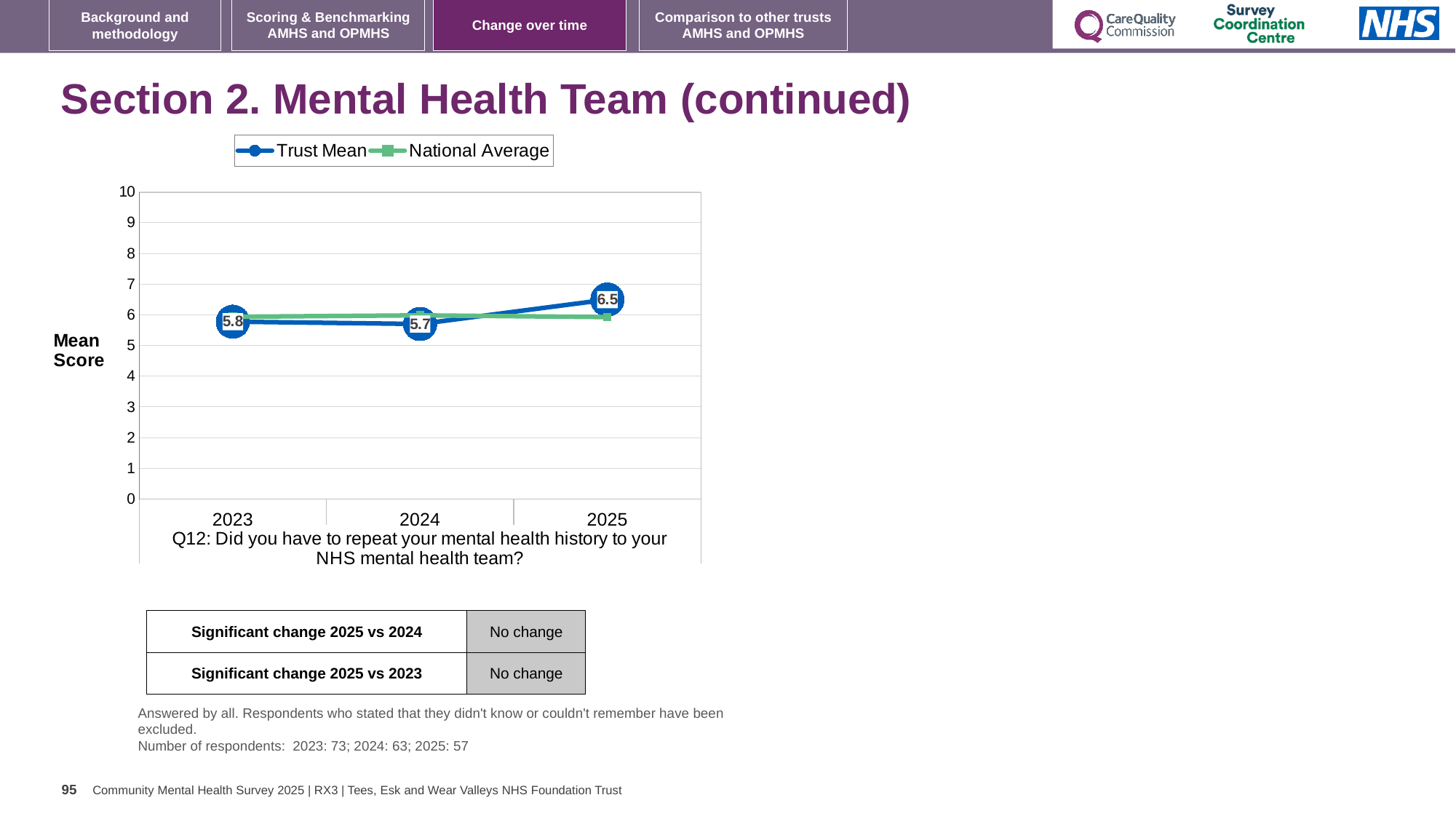
In which year is the Trust Mean score highest? 2025 Does the Trust Mean rise or fall from 2024 to 2025? rise In 2025, which is larger: the Trust Mean or the National Average? Trust Mean What is the difference between the Trust Mean scores for 2025 and 2024? 0.8 What is the Trust Mean score for 2023? 5.8 Is the National Average value for 2025 greater or less than 7? less How many series does the legend list? 2 What is the Trust Mean score for 2025? 6.5 In which year is the Trust Mean score lowest? 2024 What kind of chart is shown on the slide? line chart How many years are plotted on the x axis? 3 What is the Trust Mean score for 2024? 5.7